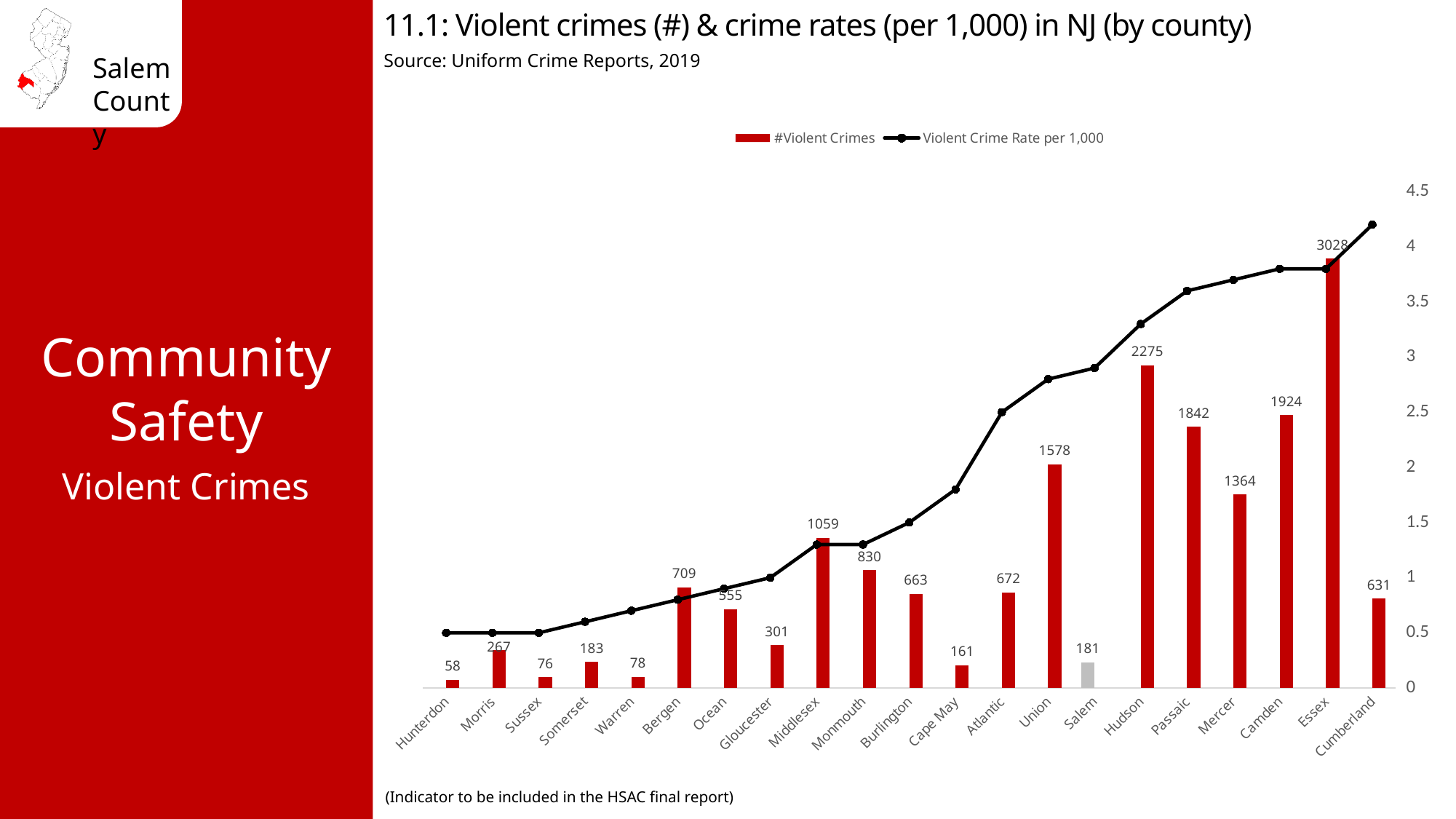
What is the number of violent crimes for Salem county? 181 What is the difference in the number of violent crimes between Essex and Hudson? 753 How many series does the legend list? 2 Is the violent crime rate per 1,000 for Cumberland greater or less than 4? greater Is the violent crime rate per 1,000 for Union greater or less than 2.5? greater Which county has the highest number of violent crimes? Essex How many counties are shown on the x axis? 21 What is the difference in the number of violent crimes between Salem and Cape May? 20 Which county has the lowest number of violent crimes? Hunterdon Which county has more violent crimes, Camden or Passaic? Camden Does the violent crime rate per 1,000 line generally rise or fall from left to right across the counties? rise What is the number of violent crimes for Middlesex county? 1059